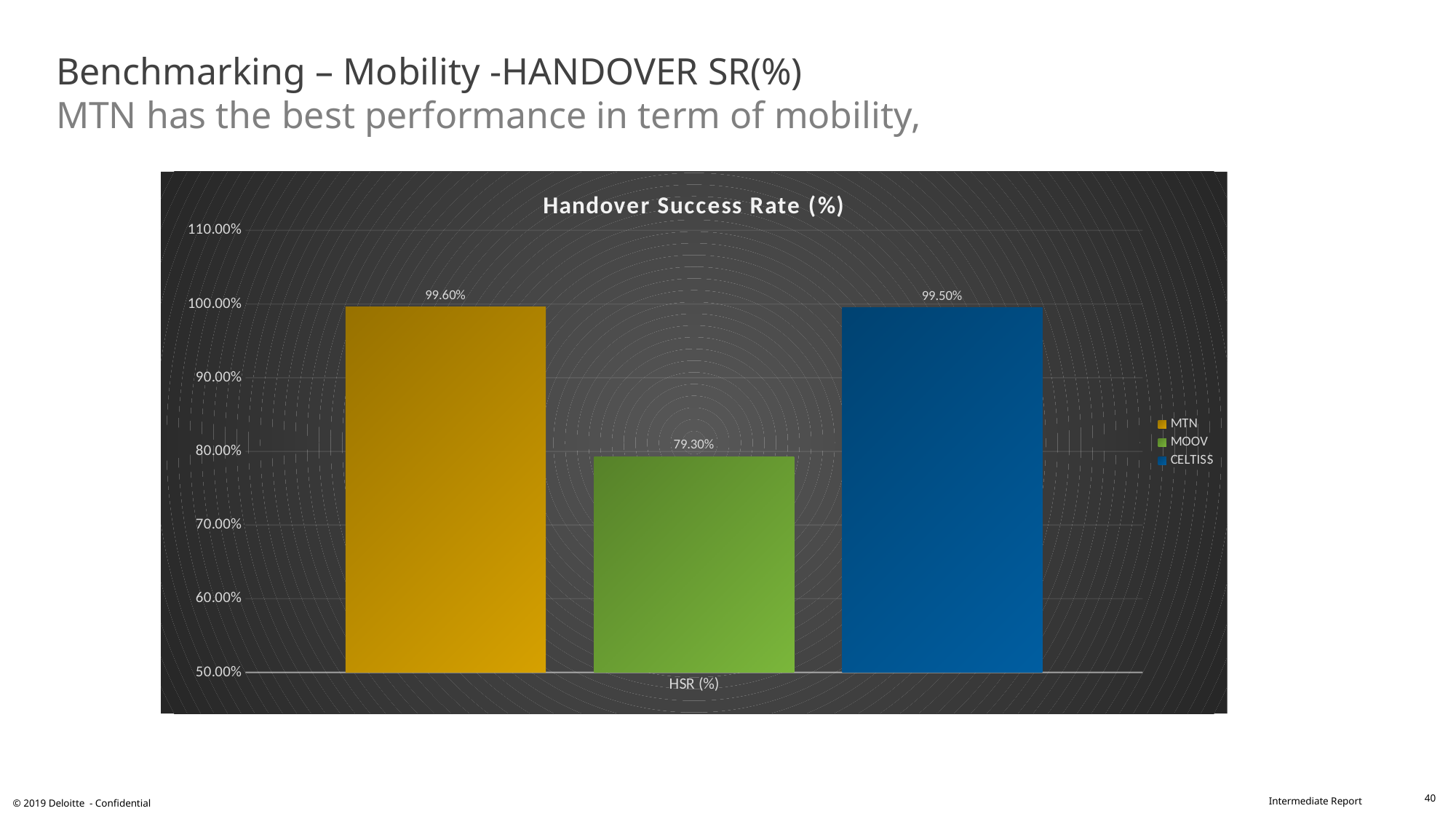
What kind of chart is shown on the slide? bar chart What is the Handover Success Rate for CELTISS? 99.50% What is the Handover Success Rate for MTN? 99.60% Is the value for MOOV greater or less than 80.00%? less What is the Handover Success Rate for MOOV? 79.30% Which has a higher Handover Success Rate, MOOV or CELTISS? CELTISS What is the difference between the Handover Success Rate of MTN and MOOV? 20.30% Which operator has the lowest Handover Success Rate? MOOV What is the title of the chart? Handover Success Rate (%) What colour is the bar for CELTISS? blue What is the difference between the Handover Success Rate of CELTISS and MOOV? 20.20% How many series does the legend list? 3